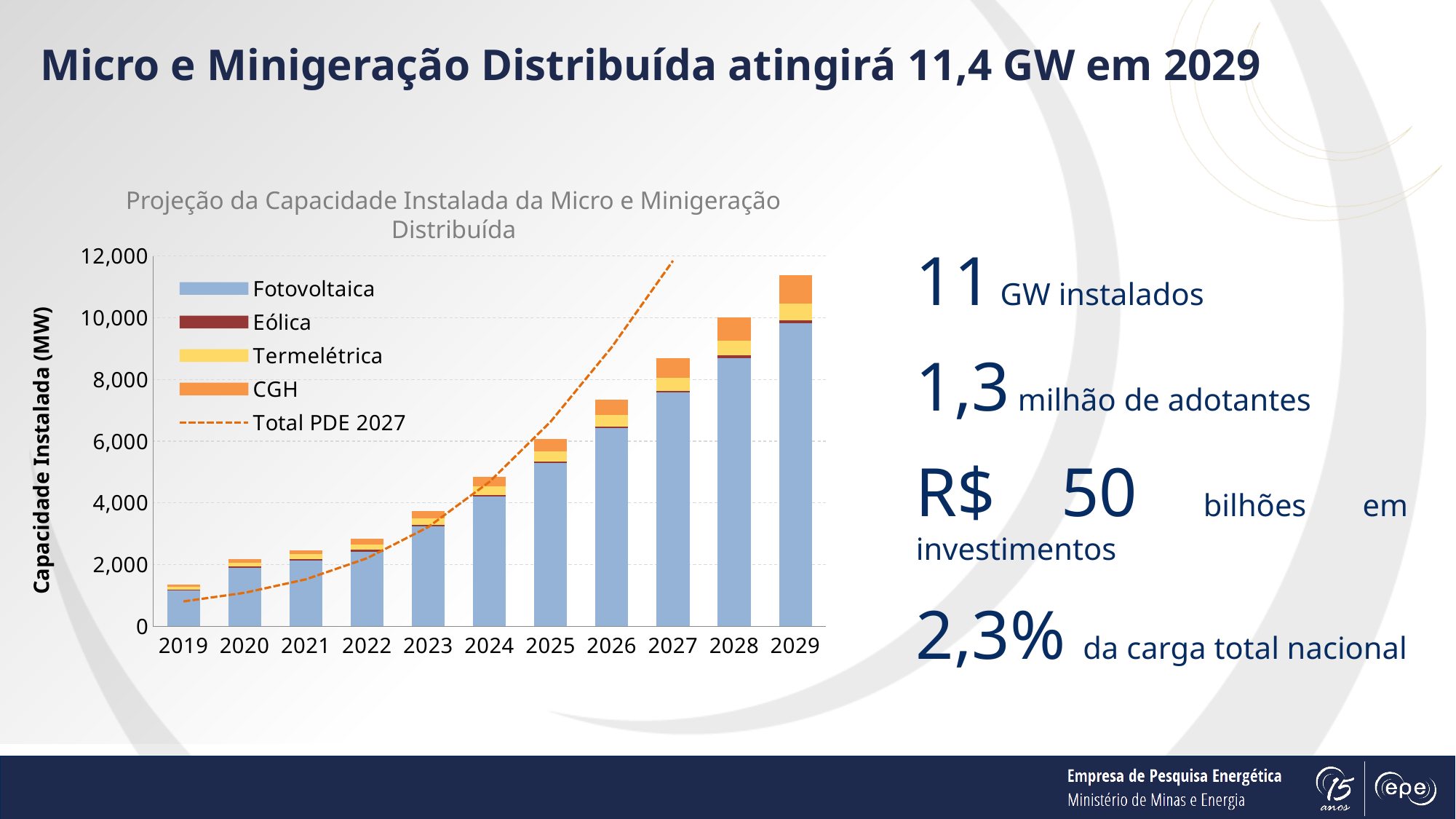
Is the total installed capacity for 2027 greater or less than 8,000 MW? greater Which year has a larger total installed capacity, 2026 or 2028? 2028 Is the total installed capacity for 2029 greater or less than 10,000 MW? greater Which year has the lowest total installed capacity in the chart? 2019 Is the total installed capacity for 2019 greater or less than 2,000 MW? less How many years are shown on the x axis of the chart? 11 What kind of chart is shown on the slide? stacked bar chart with a dashed line (combination bar and line chart) How many entries does the chart legend list? 5 What is the title of the chart? Projeção da Capacidade Instalada da Micro e Minigeração Distribuída Do the total installed capacity values rise or fall from 2019 to 2029? rise What does the dashed line in the chart represent, according to the legend? Total PDE 2027 Which year has the highest total installed capacity in the chart? 2029